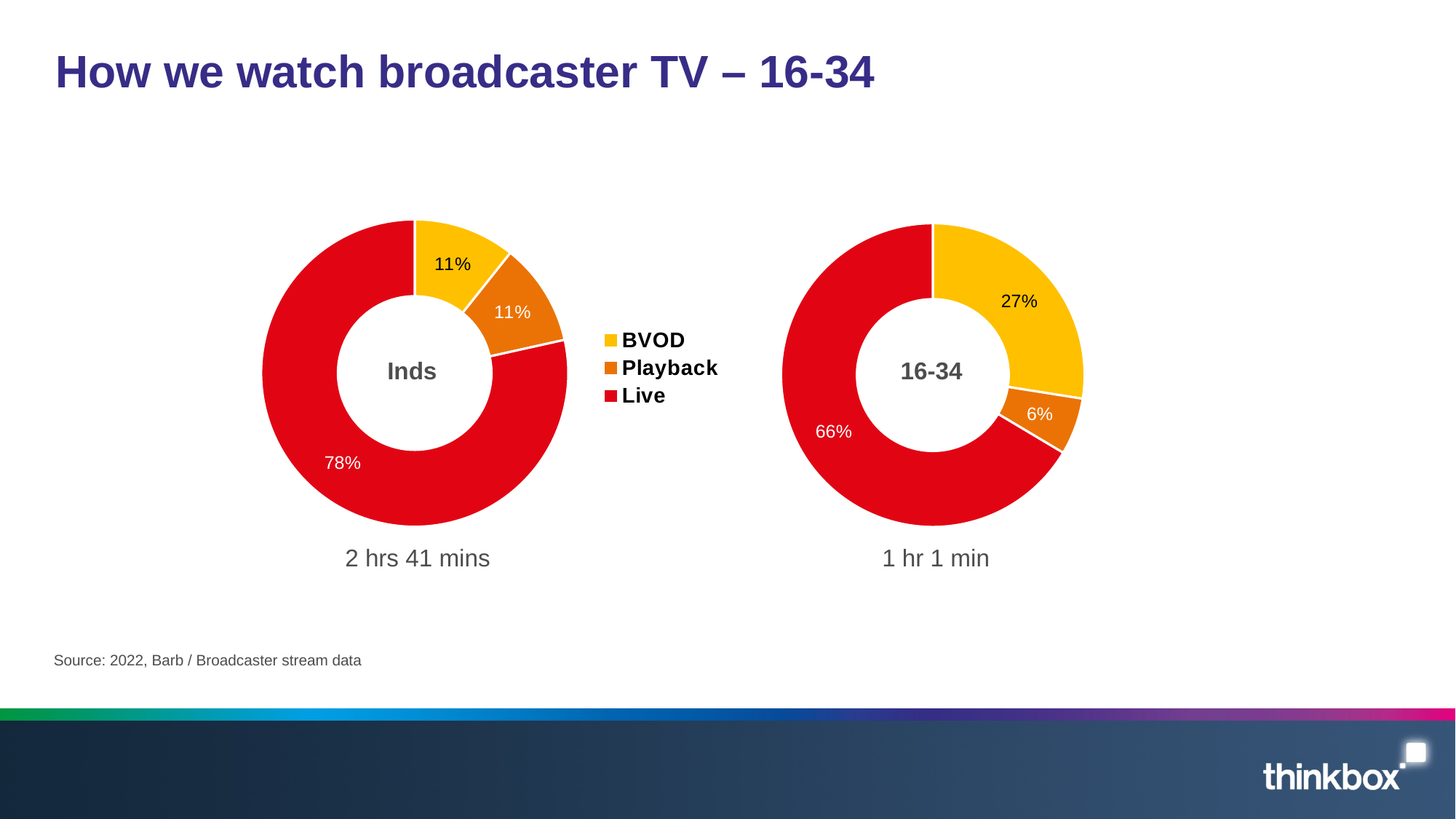
What kind of chart is used on this slide? Pie (donut) chart In the Inds chart, what share of viewing is BVOD? 11% In the 16-34 chart, which category has the largest share? Live In the 16-34 chart, which category has the smallest share? Playback In the Inds chart, what share of viewing is Live? 78% What is the difference between the Live share in the Inds chart and the Live share in the 16-34 chart? 12 percentage points Is the BVOD share larger in the Inds chart or the 16-34 chart? 16-34 In the 16-34 chart, what share of viewing is Playback? 6% What total viewing time is shown below the 16-34 chart? 1 hr 1 min How many series does the legend list? 3 In the 16-34 chart, what share of viewing is BVOD? 27% What total viewing time is shown below the Inds chart? 2 hrs 41 mins